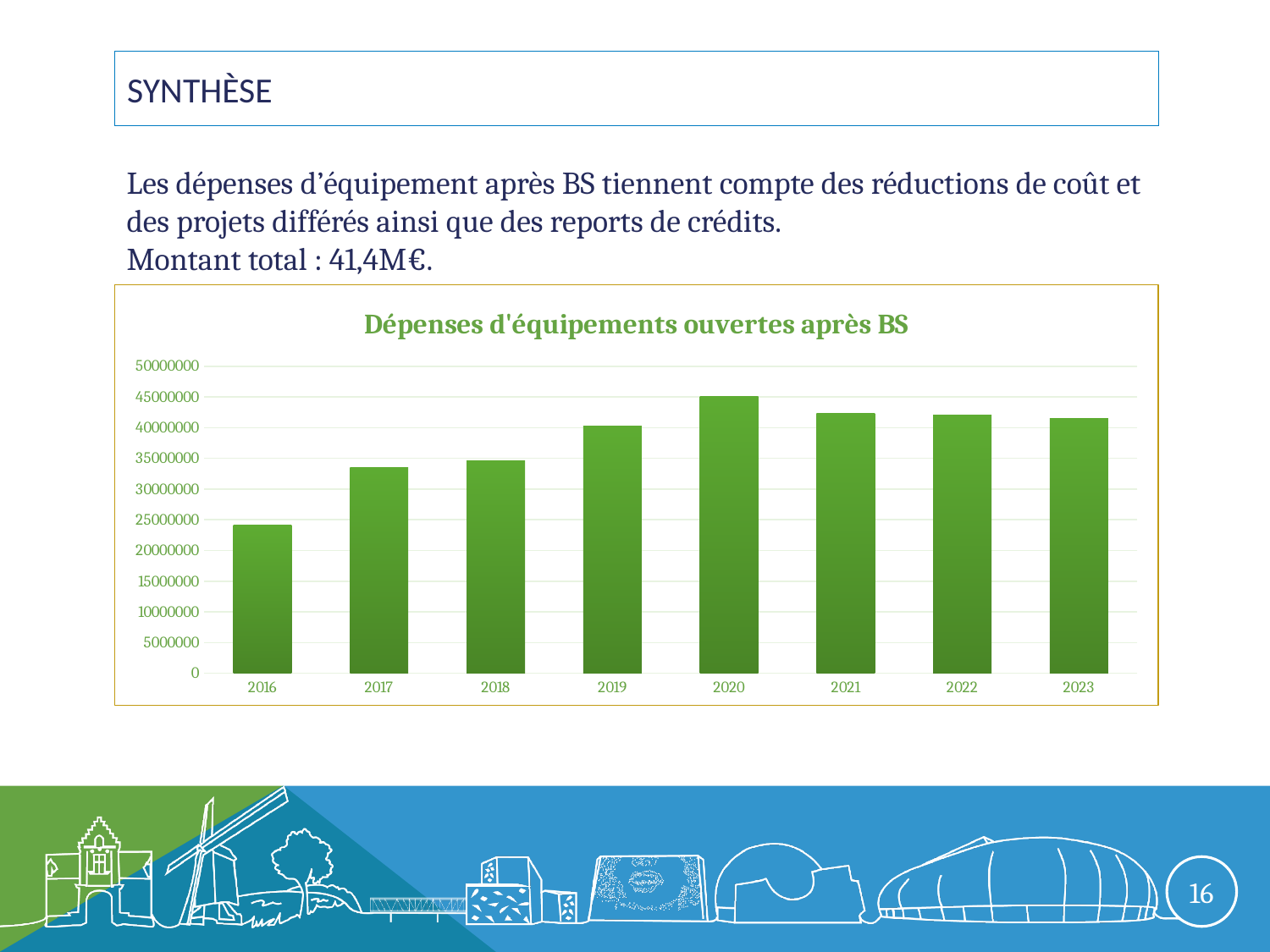
Which year has the lowest value in the chart? 2016 Is the value for 2017 greater or less than 30000000? greater Is the value for 2018 greater or less than 40000000? less Which year has the highest value in the chart? 2020 What is the title of the chart? Dépenses d'équipements ouvertes après BS How many years are shown on the x axis of the chart? 8 Is the value for 2016 greater or less than 30000000? less Do the values rise or fall from 2016 to 2020? rise What kind of chart is shown on the slide? bar chart Which is larger, the value for 2019 or the value for 2018? 2019 Which is larger, the value for 2020 or the value for 2023? 2020